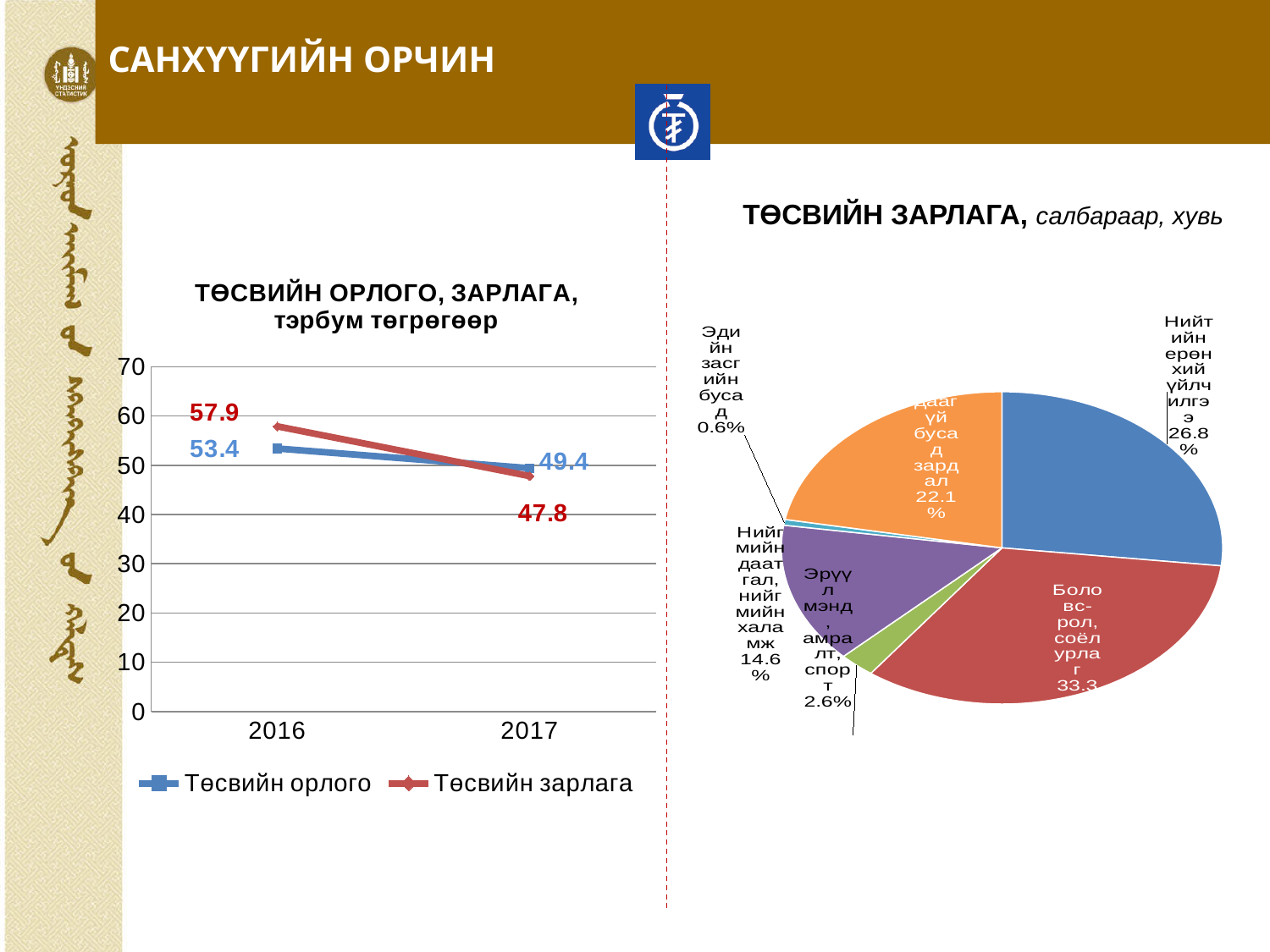
In the chart titled 'ТӨСВИЙН ОРЛОГО, ЗАРЛАГА, тэрбум төгрөгөөр', what is the value of Төсвийн зарлага in 2017? 47.8 How many series does the legend of the chart titled 'ТӨСВИЙН ОРЛОГО, ЗАРЛАГА, тэрбум төгрөгөөр' list? 2 In the pie chart titled 'ТӨСВИЙН ЗАРЛАГА, салбараар, хувь', what share does 'Боловсрол, соёл урлаг' have? 33.3% In the chart titled 'ТӨСВИЙН ОРЛОГО, ЗАРЛАГА, тэрбум төгрөгөөр', what is the value of Төсвийн зарлага in 2016? 57.9 In the pie chart titled 'ТӨСВИЙН ЗАРЛАГА, салбараар, хувь', what share does 'Нийтийн ерөнхий үйлчилгээ' have? 26.8% In the chart titled 'ТӨСВИЙН ОРЛОГО, ЗАРЛАГА, тэрбум төгрөгөөр', what is the value of Төсвийн орлого in 2016? 53.4 What kind of chart is the chart titled 'ТӨСВИЙН ОРЛОГО, ЗАРЛАГА, тэрбум төгрөгөөр'? line chart In the pie chart titled 'ТӨСВИЙН ЗАРЛАГА, салбараар, хувь', what is the difference between the shares of 'Нийгмийн даатгал, нийгмийн халамж' and 'Эрүүл мэнд, амралт, спорт'? 12.0% In the pie chart titled 'ТӨСВИЙН ЗАРЛАГА, салбараар, хувь', which sector has the smallest share? Эдийн засгийн бусад In the chart titled 'ТӨСВИЙН ОРЛОГО, ЗАРЛАГА, тэрбум төгрөгөөр', by how much did Төсвийн зарлага fall from 2016 to 2017? 10.1 In the chart titled 'ТӨСВИЙН ОРЛОГО, ЗАРЛАГА, тэрбум төгрөгөөр', which is larger in 2017, Төсвийн орлого or Төсвийн зарлага? Төсвийн орлого In the chart titled 'ТӨСВИЙН ОРЛОГО, ЗАРЛАГА, тэрбум төгрөгөөр', does Төсвийн орлого rise or fall from 2016 to 2017? fall